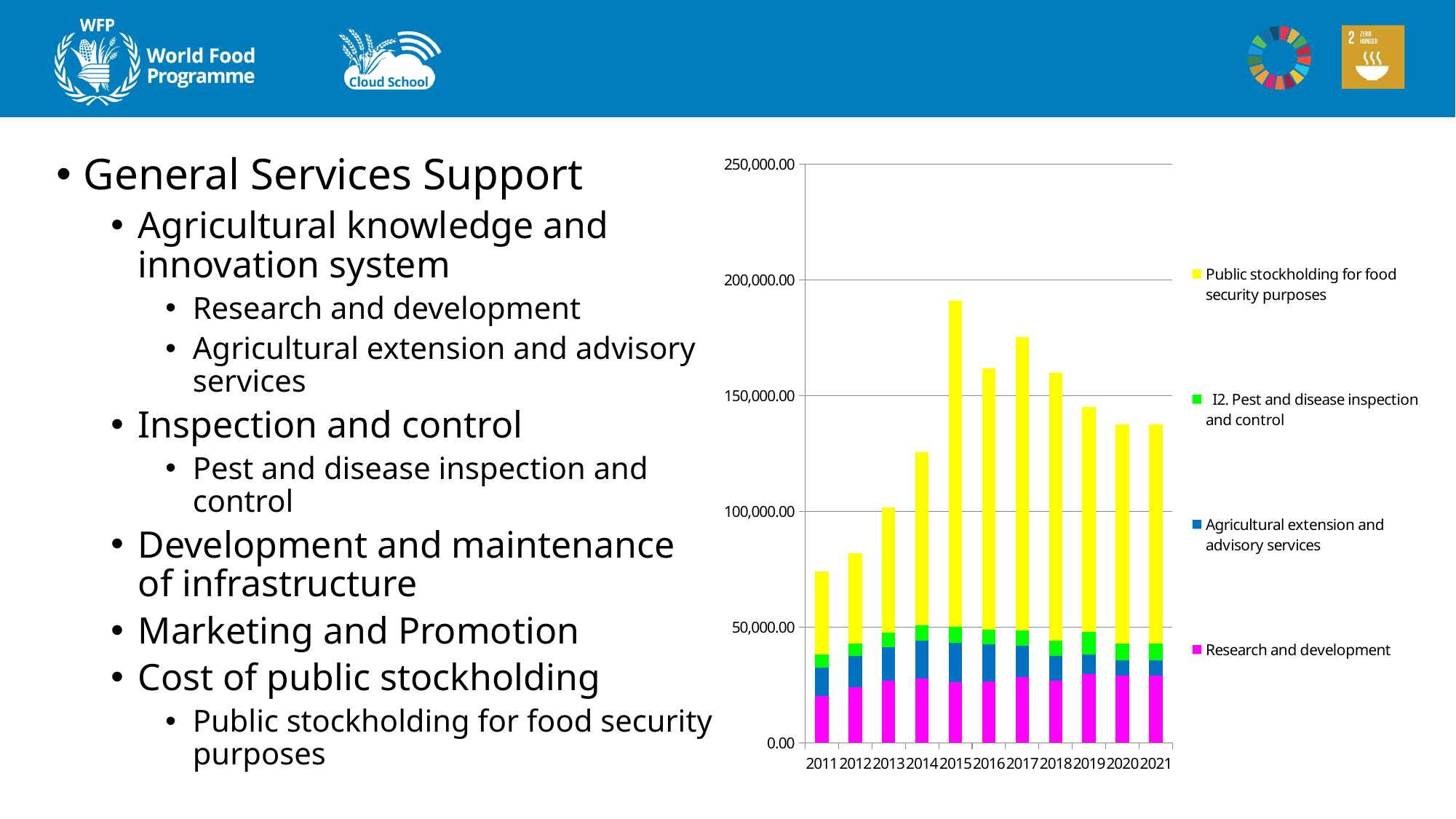
Which year has the larger total stacked bar, 2015 or 2017? 2015 How many series does the chart's legend list? 4 Is the total of the stacked bar for 2014 greater or less than 100,000.00? greater How many years are shown along the x axis of the chart? 11 What kind of chart is shown on the slide? Stacked bar chart Which year has the tallest stacked bar (highest total)? 2015 Which year has the shortest stacked bar (lowest total)? 2011 Do the total bar heights rise or fall from 2011 to 2015? rise Is the total of the stacked bar for 2015 greater or less than 150,000.00? greater Which series is shown in yellow in the chart? Public stockholding for food security purposes Is the total of the stacked bar for 2011 greater or less than 50,000.00? greater